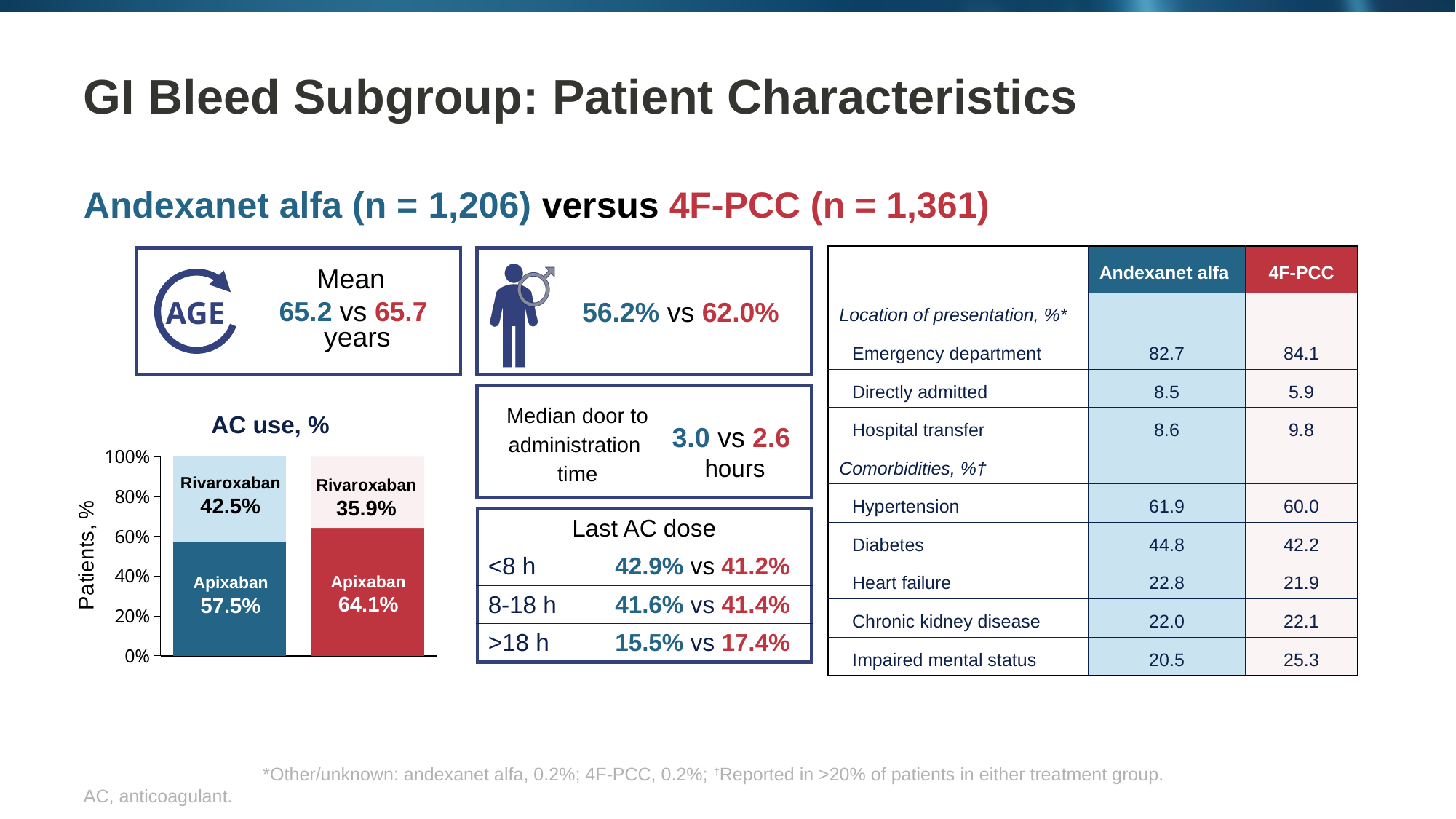
What kind of chart is the "AC use, %" chart? bar chart In the "AC use, %" chart, is the Rivaroxaban value for the right (red) bar greater or less than 40%? less In the "AC use, %" chart, what is the Apixaban value for the right (red) bar? 64.1% In the "AC use, %" chart, what is the difference between the Apixaban values of the right bar and the left bar? 6.6% What is the y-axis label of the "AC use, %" chart? Patients, % How many bars are shown in the "AC use, %" chart? 2 In the "AC use, %" chart, what is the Apixaban value for the left (blue) bar? 57.5% In the "AC use, %" chart, what is the difference between the Rivaroxaban values of the left bar and the right bar? 6.6% In the "AC use, %" chart, what is the Rivaroxaban value for the right (red) bar? 35.9% In the "AC use, %" chart, which bar has the larger Apixaban segment, the left (blue) bar or the right (red) bar? the right (red) bar In the "AC use, %" chart, what is the Rivaroxaban value for the left (blue) bar? 42.5% In the "AC use, %" chart, what is the total of the left (blue) stacked bar? 100%